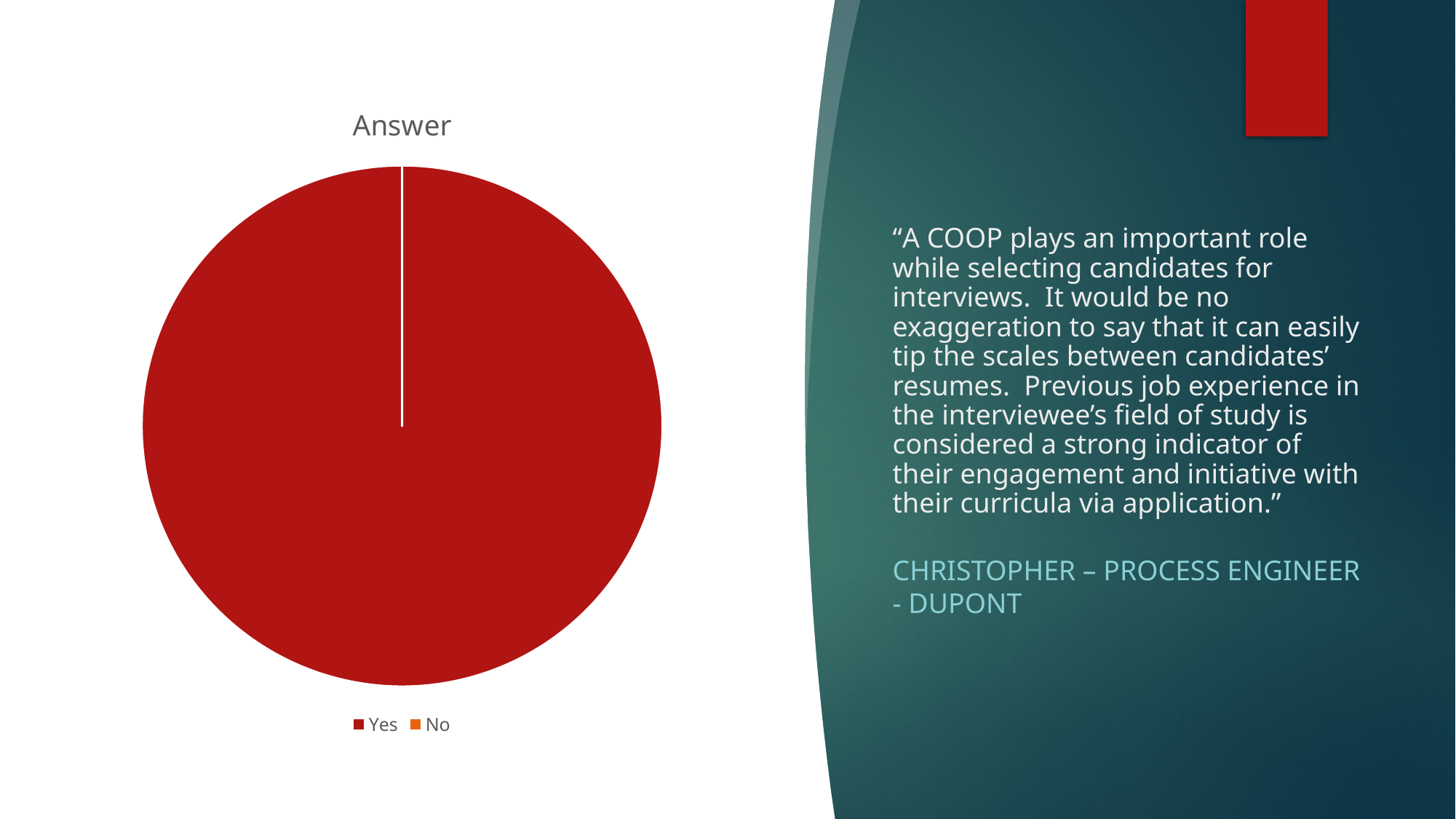
How many categories does the chart's legend show? 2 Which is larger, the share for Yes or the share for No? Yes What colour is the Yes slice in the legend? red How many entries does the chart's legend list? 2 What kind of chart is shown on the slide? pie chart Which category takes up the largest share of the pie? Yes What is the title of the chart? Answer Which category has the smallest share of the pie? No